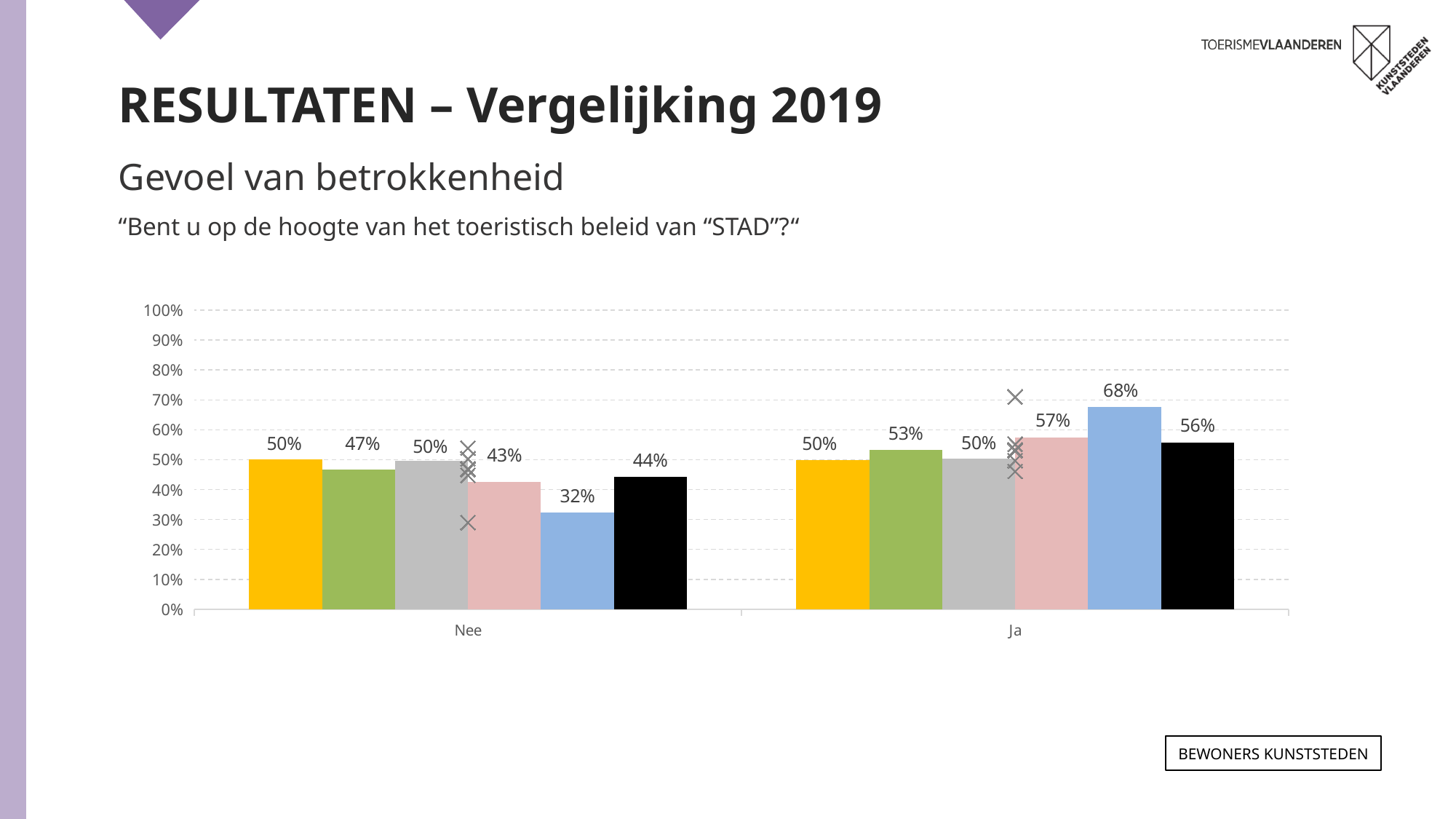
What is the value of the black bar for "Ja"? 56% What is the value of the blue bar for "Ja"? 68% What kind of chart is shown on the slide? bar chart How many categories are shown on the x axis of the chart? 2 How many bars are plotted for the category "Ja"? 6 Is the green bar larger for "Nee" or for "Ja"? Ja What is the value of the pink bar for "Nee"? 43% What are the two category labels on the x axis of the chart? Nee and Ja What is the value of the blue bar for "Nee"? 32% Which bar has the lowest value in the "Nee" category? the blue bar (32%) What is the difference between the blue bar for "Ja" and the blue bar for "Nee"? 36 percentage points Which bar has the highest value in the "Ja" category? the blue bar (68%)